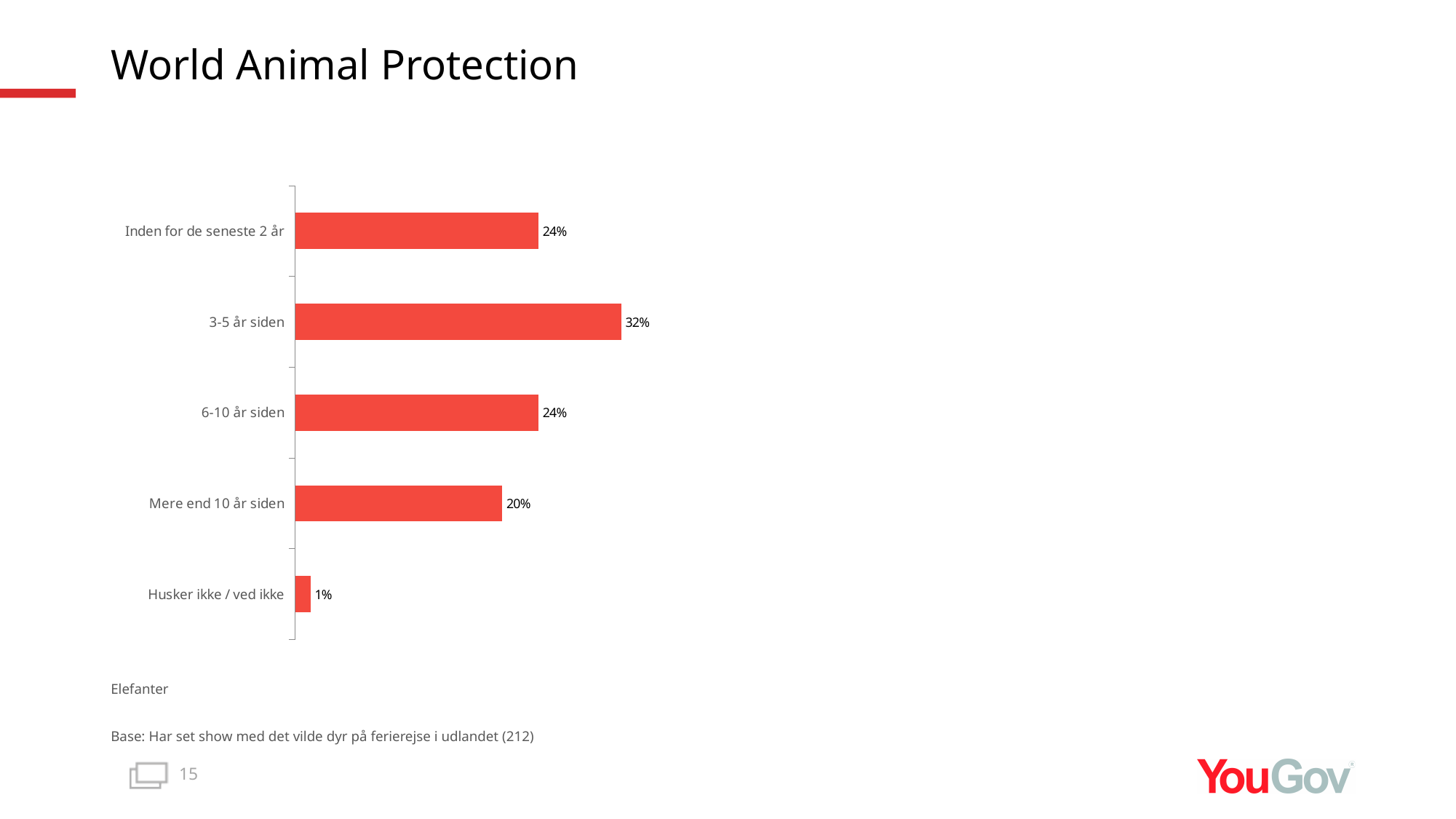
What is the value for "Inden for de seneste 2 år"? 24% What is the value for "Husker ikke / ved ikke"? 1% What label appears below the chart indicating the animal the data refers to? Elefanter What is the difference between the values for "3-5 år siden" and "Husker ikke / ved ikke"? 31 percentage points What is the value for "3-5 år siden"? 32% Which is larger: the value for "6-10 år siden" or the value for "Mere end 10 år siden"? 6-10 år siden What is the value for "Mere end 10 år siden"? 20% What is the difference between the values for "3-5 år siden" and "Mere end 10 år siden"? 12 percentage points How many categories are shown in the chart? 5 What kind of chart is shown on the slide? Bar chart Which category has the lowest value? Husker ikke / ved ikke Which category has the highest value? 3-5 år siden